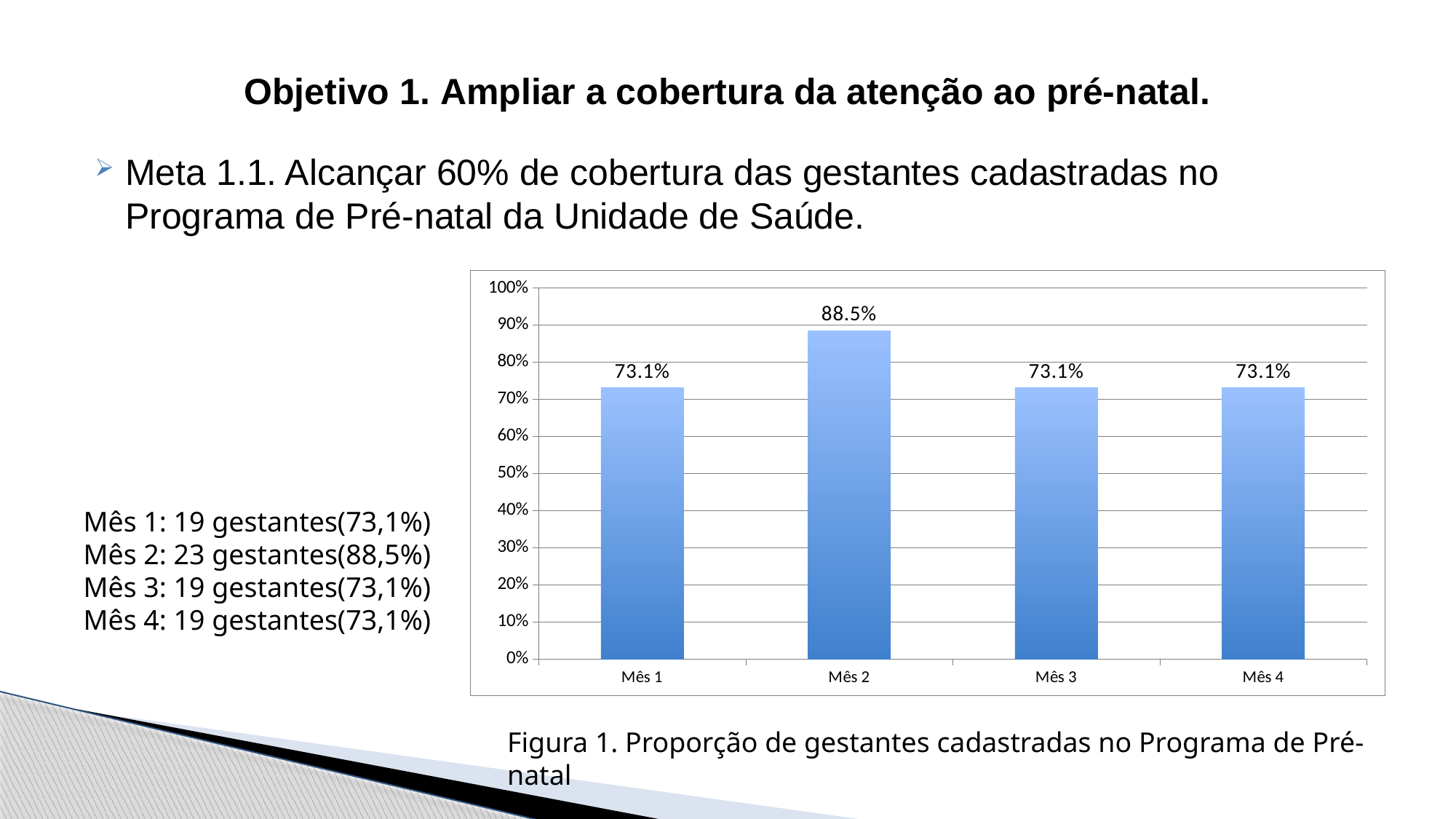
What is the value for Mês 2? 88.5% What is the value for Mês 4? 73.1% Is the value for Mês 2 greater or less than 90%? less Is the value for Mês 3 greater or less than 60%? greater What is the highest value shown on the y axis? 100% Which is larger, the value for Mês 2 or the value for Mês 4? Mês 2 What is the value for Mês 1? 73.1% What is the difference between the values for Mês 2 and Mês 3? 15.4% How many months are shown on the x axis? 4 Which month has the highest value? Mês 2 What kind of chart is shown on the slide? Bar chart What is the caption of the figure below the chart? Figura 1. Proporção de gestantes cadastradas no Programa de Pré-natal